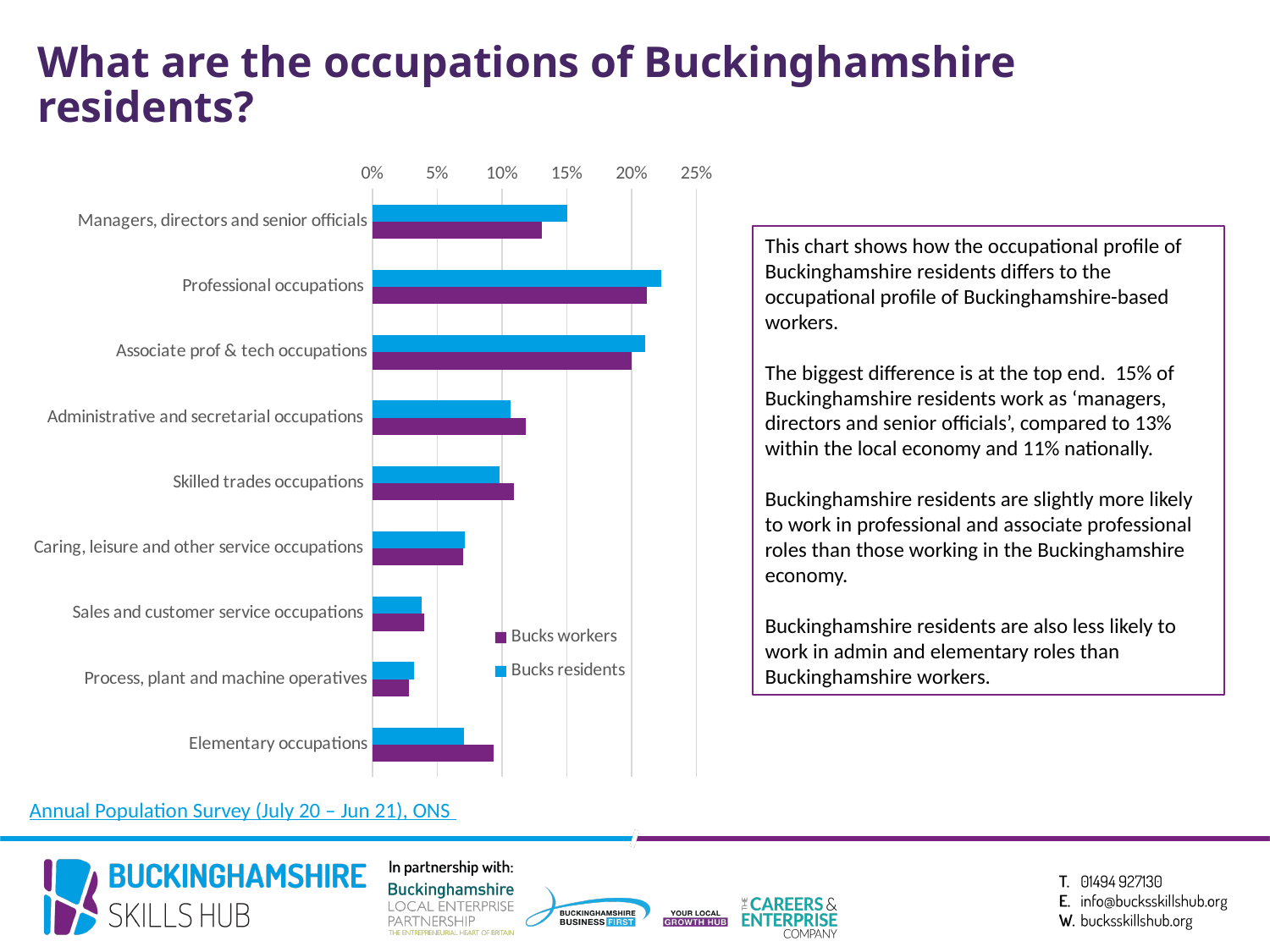
What kind of chart is shown on the slide? Bar chart Which occupation category has the lowest value for Bucks workers? Process, plant and machine operatives Which occupation category has the highest value for Bucks residents? Professional occupations What is the Bucks residents value for Managers, directors and senior officials? 15% What are the two series named in the chart legend? Bucks workers and Bucks residents For Administrative and secretarial occupations, which series has the larger value, Bucks workers or Bucks residents? Bucks workers For Managers, directors and senior officials, which series has the larger value, Bucks workers or Bucks residents? Bucks residents Is the Bucks workers value for Elementary occupations greater or less than 5%? greater Is the Bucks residents value for Professional occupations greater or less than 20%? greater How many occupation categories are plotted on the chart? 9 Is the Bucks residents value for Sales and customer service occupations greater or less than 5%? less How many series does the chart legend list? 2